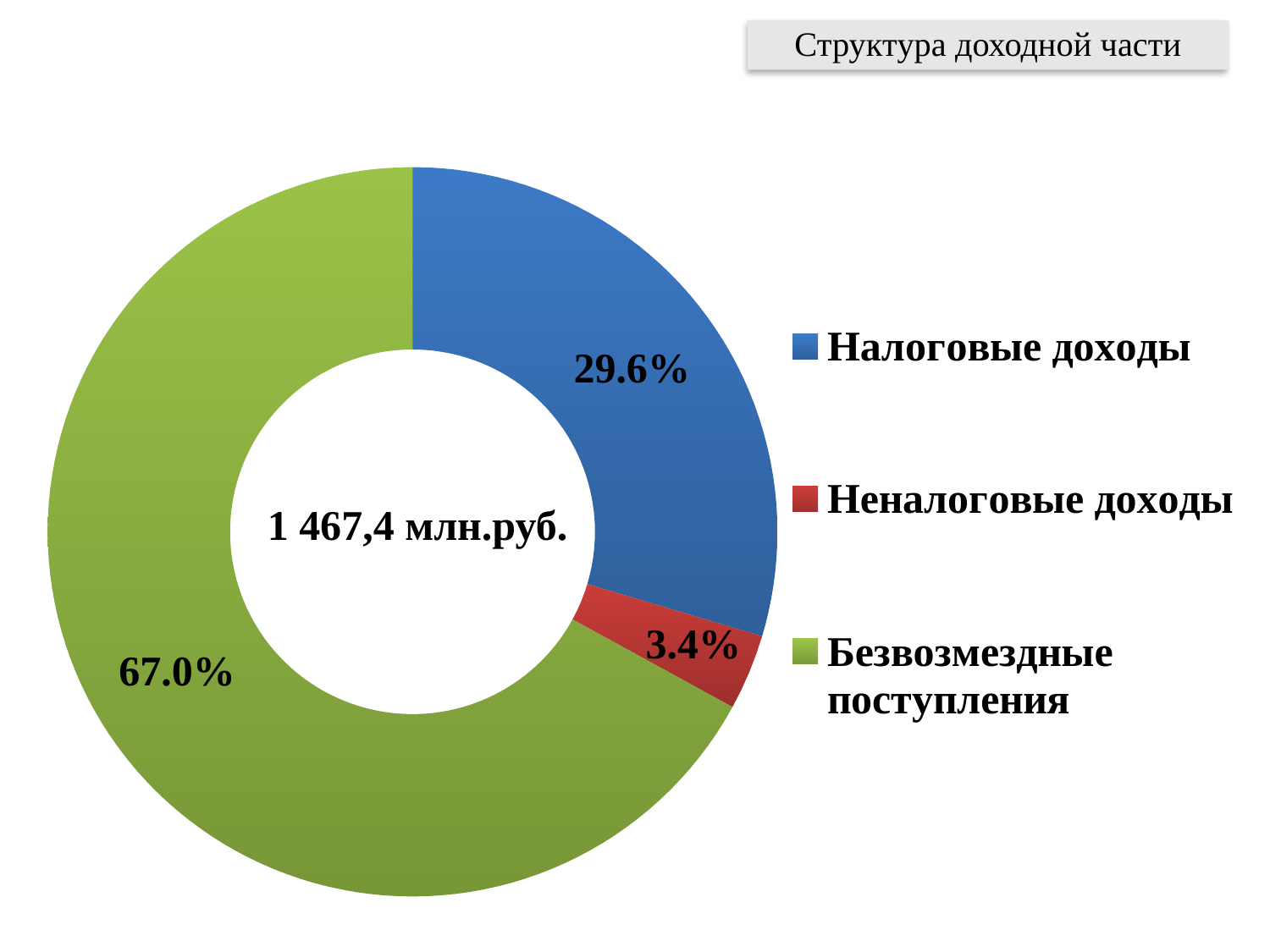
What is the difference in percentage points between Налоговые доходы and Неналоговые доходы? 26.2 What total value is printed in the centre of the chart? 1 467,4 млн.руб. Which is larger, the share of Налоговые доходы or the share of Неналоговые доходы? Налоговые доходы How many categories does the chart show? 3 What is the title shown on the slide? Структура доходной части What share of the chart does Безвозмездные поступления represent? 67.0% What share of the chart does Налоговые доходы represent? 29.6% Which category has the smallest share? Неналоговые доходы What kind of chart is shown on the slide? Doughnut (pie) chart What is the difference in percentage points between Безвозмездные поступления and Налоговые доходы? 37.4 Which category has the largest share? Безвозмездные поступления What share of the chart does Неналоговые доходы represent? 3.4%